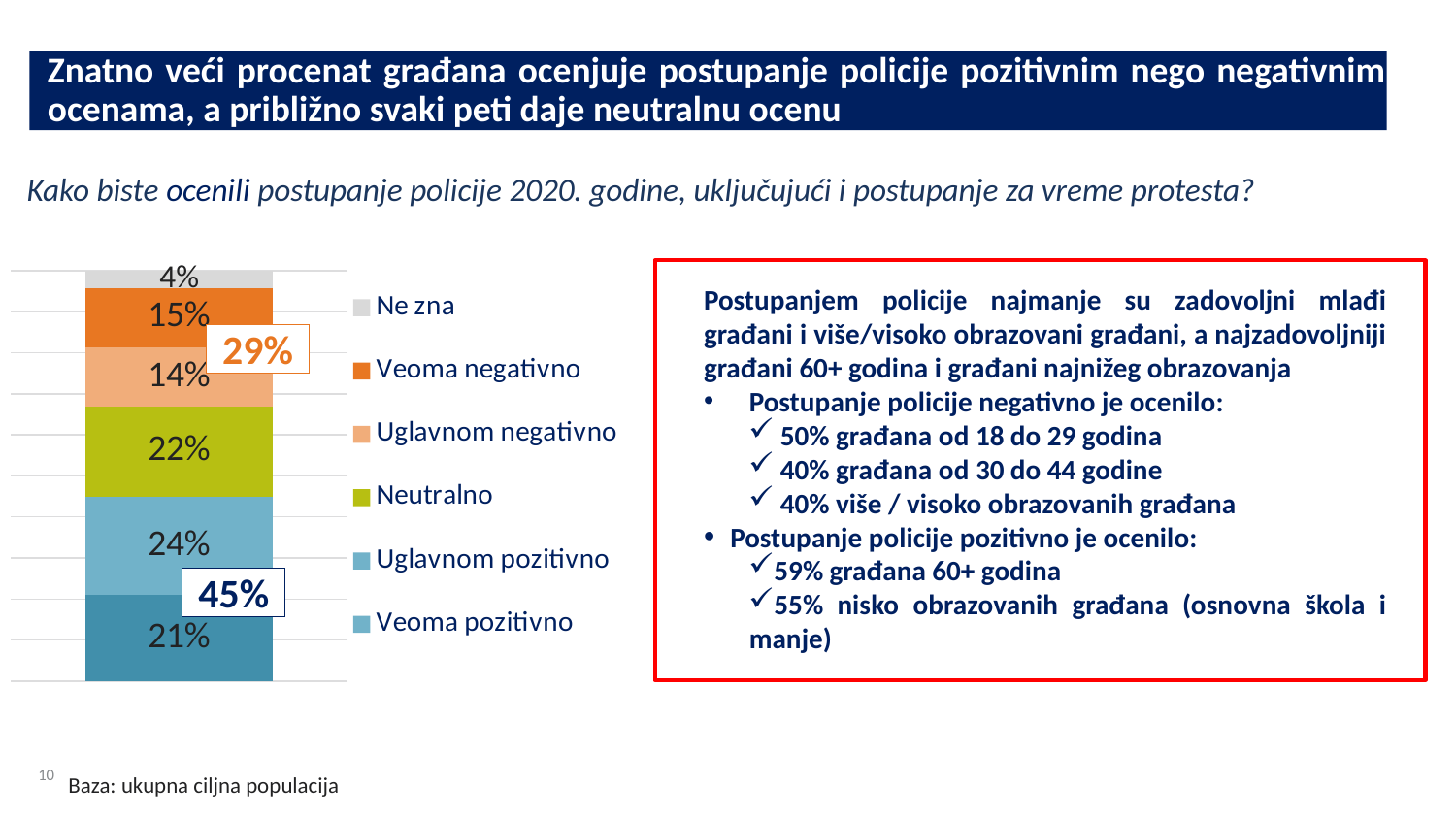
What type of chart is shown on the slide? Stacked bar chart What percentage of respondents answered "Ne zna"? 4% How many response categories does the legend list? 6 What percentage of respondents answered "Neutralno"? 22% What is the combined share of "Uglavnom pozitivno" and "Veoma pozitivno" as labelled on the chart? 45% Which is larger, the share for "Neutralno" or the share for "Veoma negativno"? Neutralno What is the combined share of "Veoma negativno" and "Uglavnom negativno" as labelled on the chart? 29% What percentage of respondents answered "Uglavnom negativno"? 14% What is the difference between the "Uglavnom pozitivno" and "Veoma negativno" shares? 9 percentage points What percentage of respondents answered "Veoma pozitivno"? 21% Which response category has the smallest share in the stacked bar? Ne zna Which response category has the largest share in the stacked bar? Uglavnom pozitivno